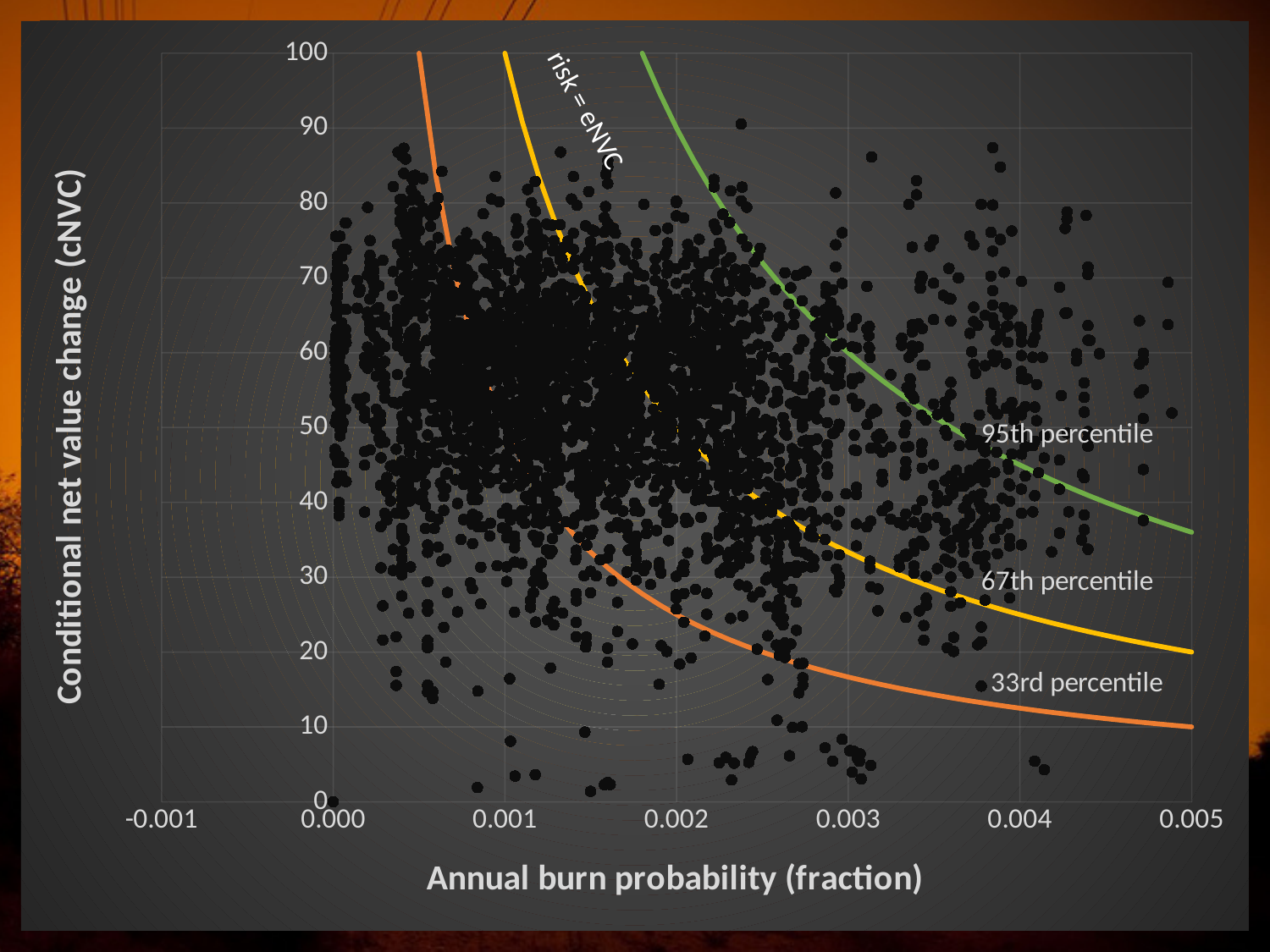
Which percentile curve lies lowest on the chart? 33rd percentile Which percentile curve lies highest on the chart? 95th percentile Do the percentile curves rise or fall as annual burn probability increases? Fall How many percentile curves are drawn over the scatter points? 3 What kind of chart is shown on the slide? Scatter chart What is the maximum value shown on the x axis? 0.005 Which curve is higher at an annual burn probability of 0.004, the 67th percentile or the 33rd percentile? 67th percentile What is the label of the y axis? Conditional net value change (cNVC) What is the maximum value shown on the y axis? 100 At an annual burn probability of 0.005, is the 33rd percentile curve greater or less than 20? less At an annual burn probability of 0.005, is the 95th percentile curve greater or less than 30? greater